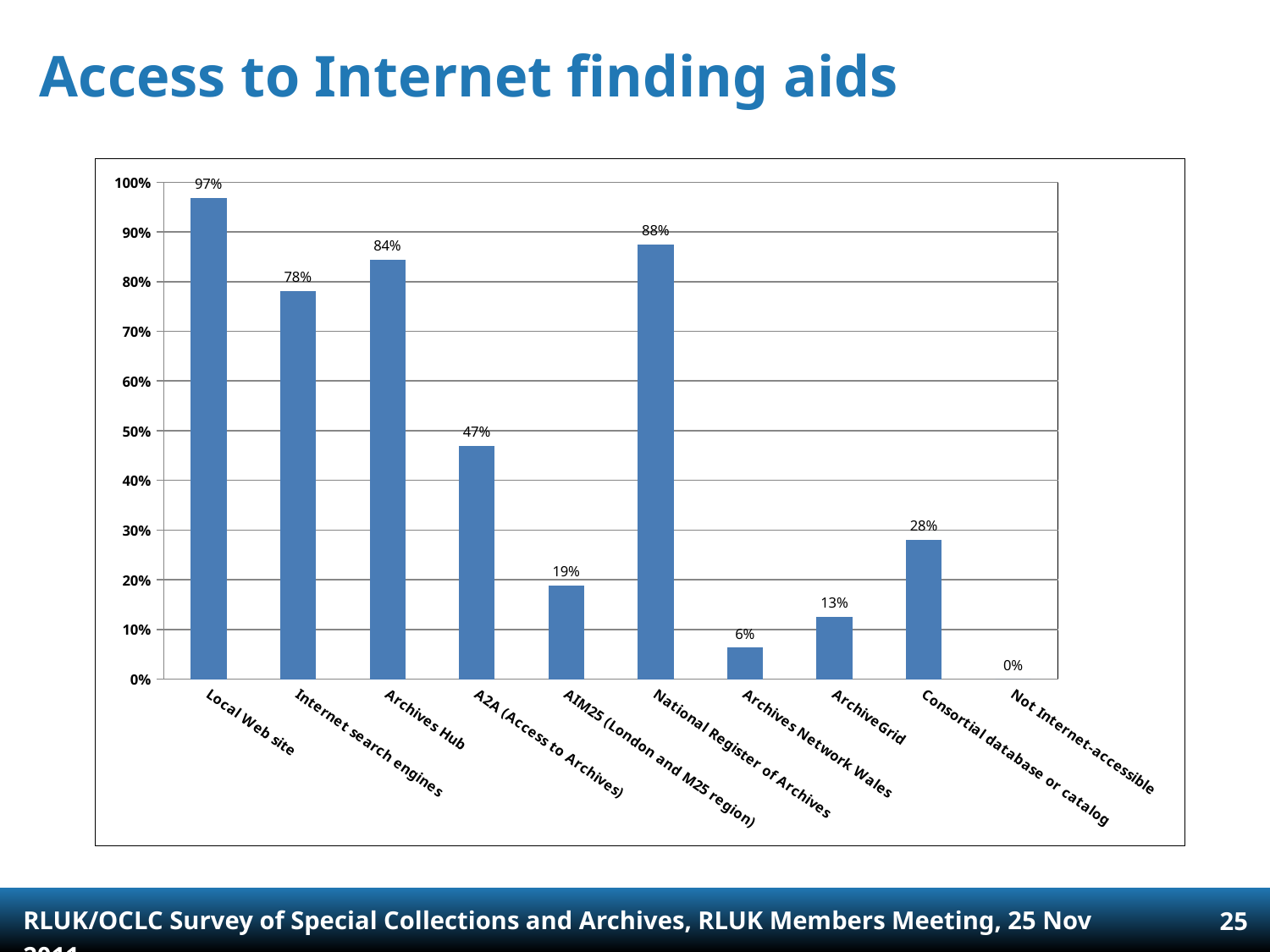
Which is larger, the value for Internet search engines or the value for Archives Hub? Archives Hub What is the difference between the values for Archives Hub and A2A (Access to Archives)? 37% What is the value for Consortial database or catalog? 28% Which category has the lowest value? Not Internet-accessible What is the value for Local Web site? 97% What is the value for Archives Network Wales? 6% How many categories are shown on the x axis? 10 Which category has the highest value? Local Web site What is the value for National Register of Archives? 88% Is the value for AIM25 (London and M25 region) greater or less than 20%? less What kind of chart is shown on the slide? bar chart What is the title of the slide containing the chart? Access to Internet finding aids